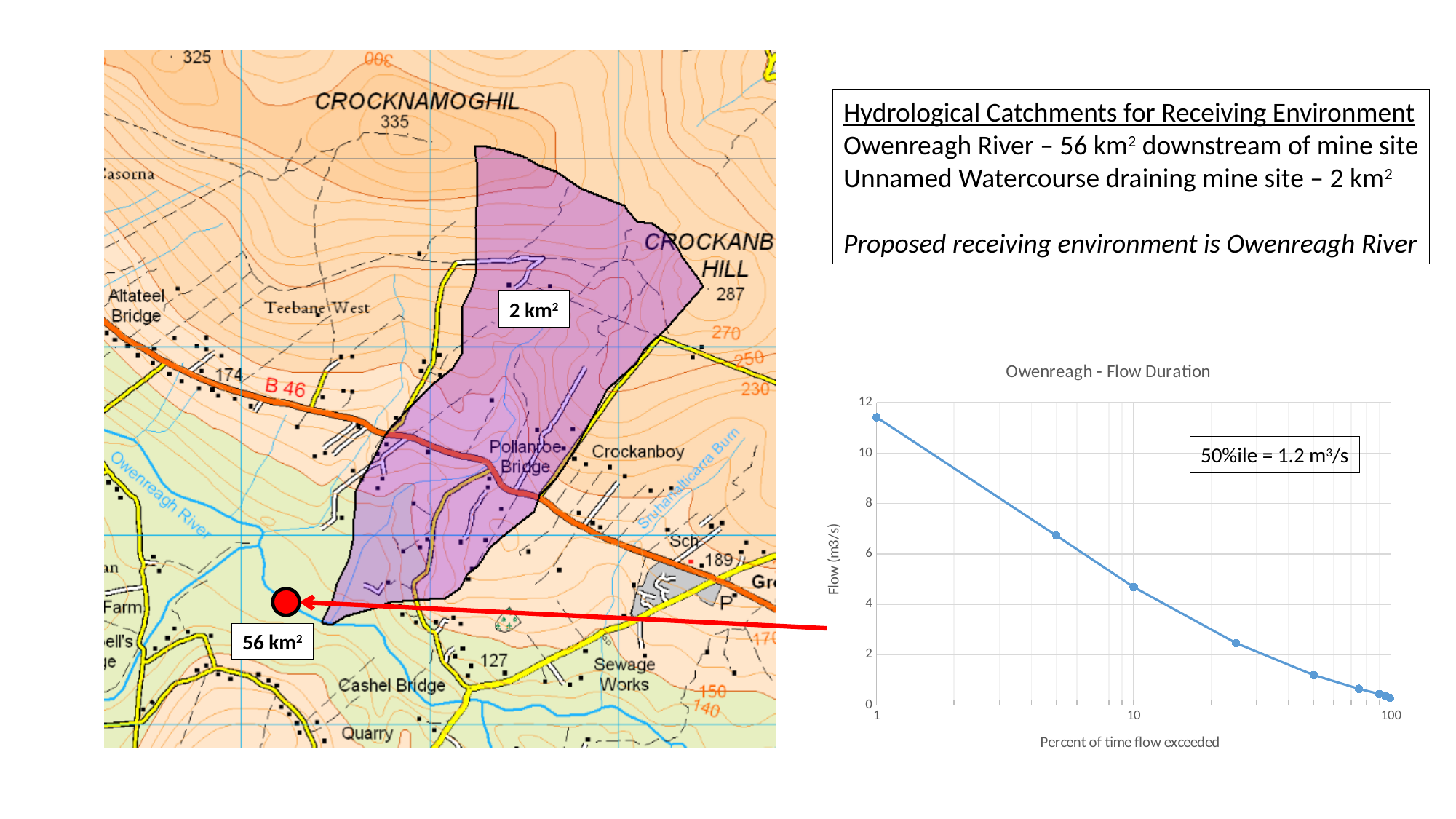
On the Owenreagh - Flow Duration chart, is the flow at 10 percent of time exceeded greater or less than 4 m3/s? greater On the Owenreagh - Flow Duration chart, at which percent of time flow exceeded is the flow highest? 1 According to the annotation on the Owenreagh - Flow Duration chart, what is the flow at the 50th percentile? 1.2 m³/s On the Owenreagh - Flow Duration chart, is the flow at 1 percent of time exceeded greater or less than 10 m3/s? greater What is the title of the chart on the slide? Owenreagh - Flow Duration On the Owenreagh - Flow Duration chart, which is larger: the flow at 1 percent of time exceeded or the flow at 10 percent of time exceeded? 1 percent What is the label of the y axis on the Owenreagh - Flow Duration chart? Flow (m3/s) On the Owenreagh - Flow Duration chart, is the flow at 10 percent of time exceeded greater or less than 6 m3/s? less On the Owenreagh - Flow Duration chart, does the flow rise or fall as the percent of time flow exceeded increases? fall What kind of chart is the Owenreagh - Flow Duration chart? line chart